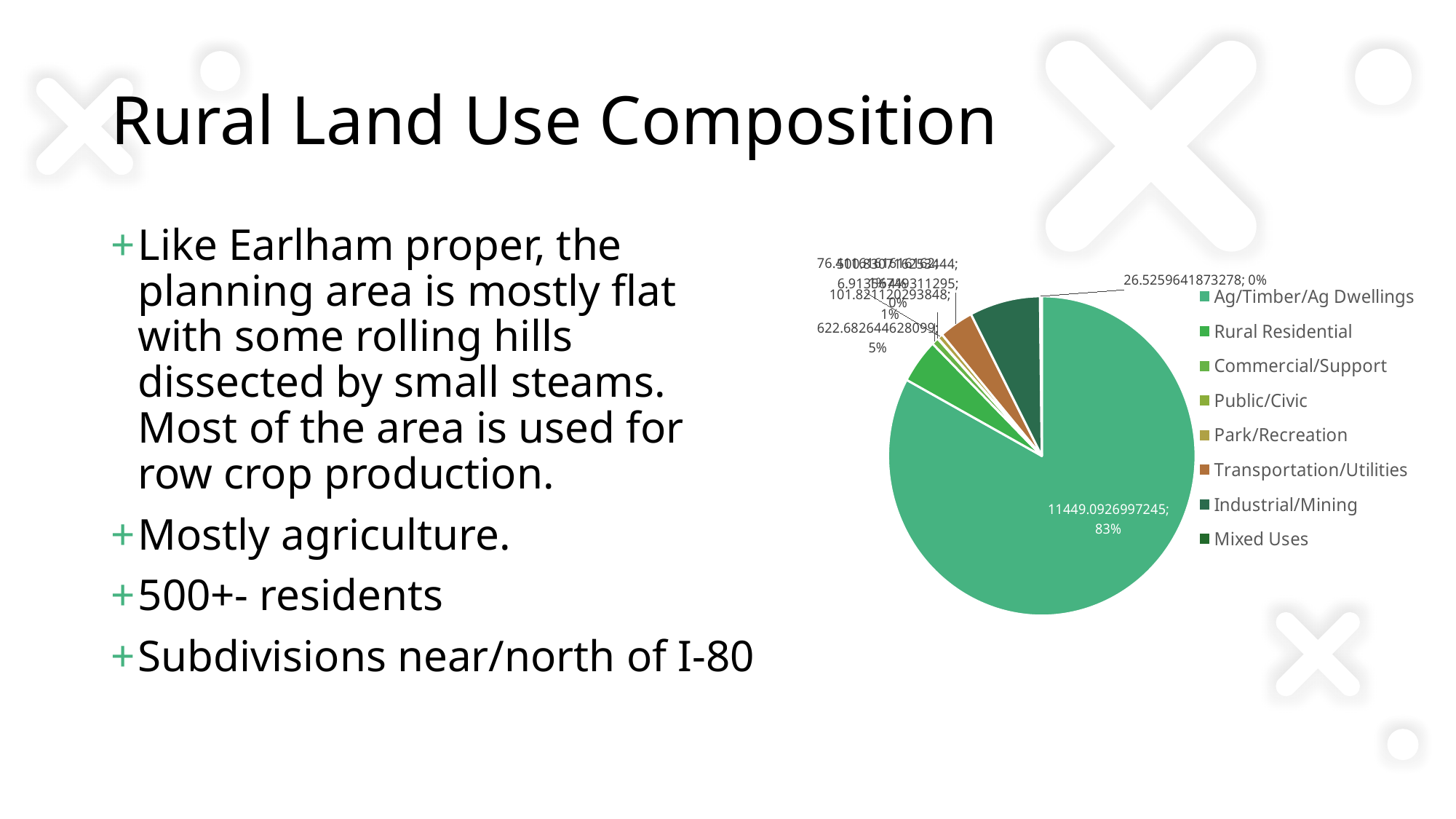
What is the last entry listed in the pie chart's legend? Mixed Uses Which is larger, the Rural Residential slice or the Transportation/Utilities slice? Rural Residential What is the first entry listed in the pie chart's legend? Ag/Timber/Ag Dwellings Which category has the largest slice of the pie chart? Ag/Timber/Ag Dwellings What value is labelled on the Rural Residential slice? 622.682644628099 How many land use categories does the legend of the pie chart list? 8 What value is labelled on the Ag/Timber/Ag Dwellings slice? 11449.0926997245 Which is larger, the Ag/Timber/Ag Dwellings slice or the Rural Residential slice? Ag/Timber/Ag Dwellings What kind of chart is shown on the slide? pie chart What share of the pie does Ag/Timber/Ag Dwellings account for? 83% What share of the pie does Rural Residential account for? 5%